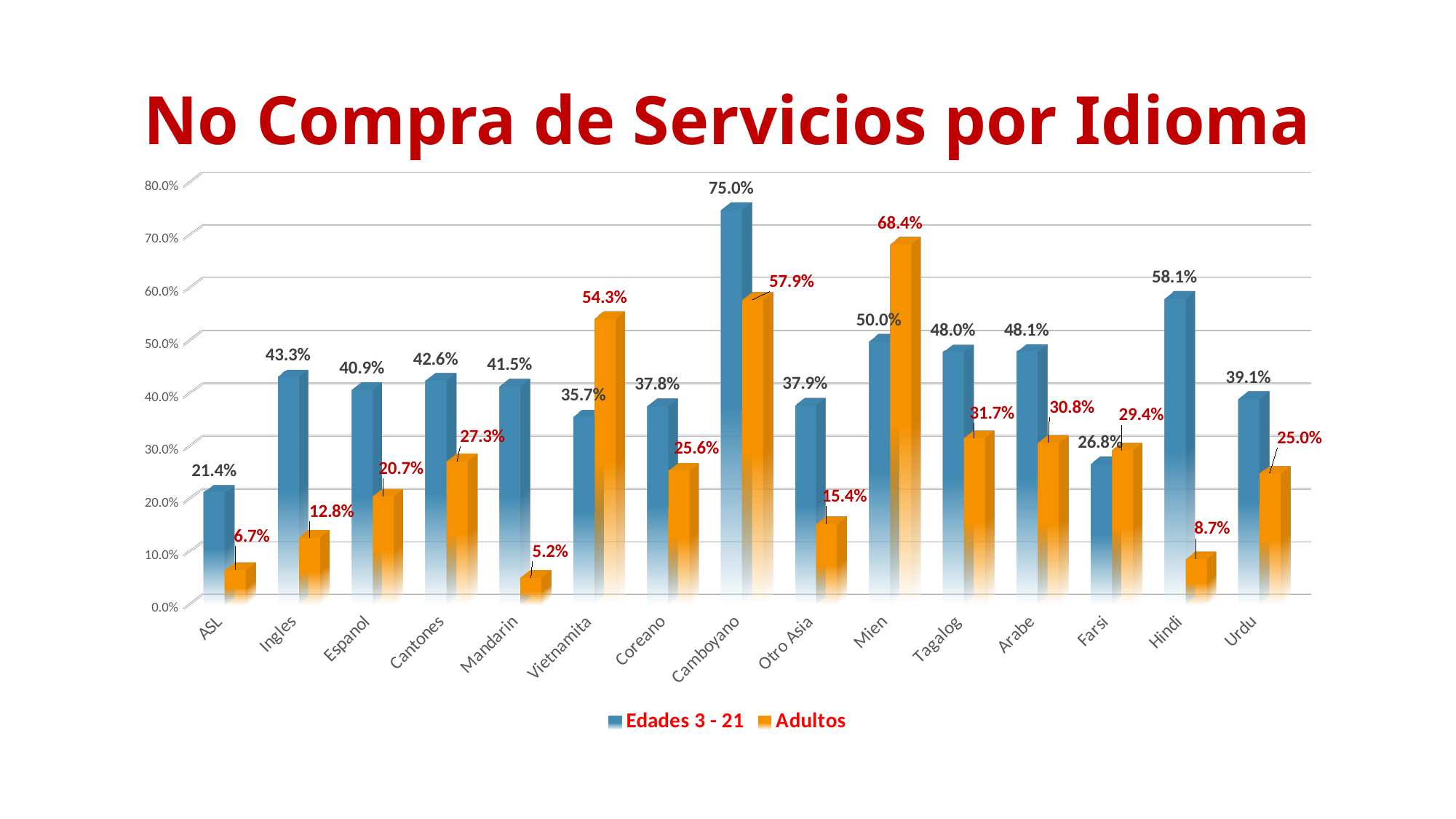
What is the Adultos value for Mandarin? 5.2% Which language has the highest Adultos value? Mien What is the Edades 3 - 21 value for Camboyano? 75.0% Which language has the lowest Adultos value? Mandarin How many languages are shown on the x axis? 15 Which language has the lowest Edades 3 - 21 value? ASL What type of chart is shown on the slide? Bar chart Which language has the highest Edades 3 - 21 value? Camboyano What is the Adultos value for Vietnamita? 54.3% What is the difference between the Edades 3 - 21 and Adultos values for Hindi? 49.4 percentage points How many series does the legend list? 2 For Vietnamita, which series has the larger value, Edades 3 - 21 or Adultos? Adultos